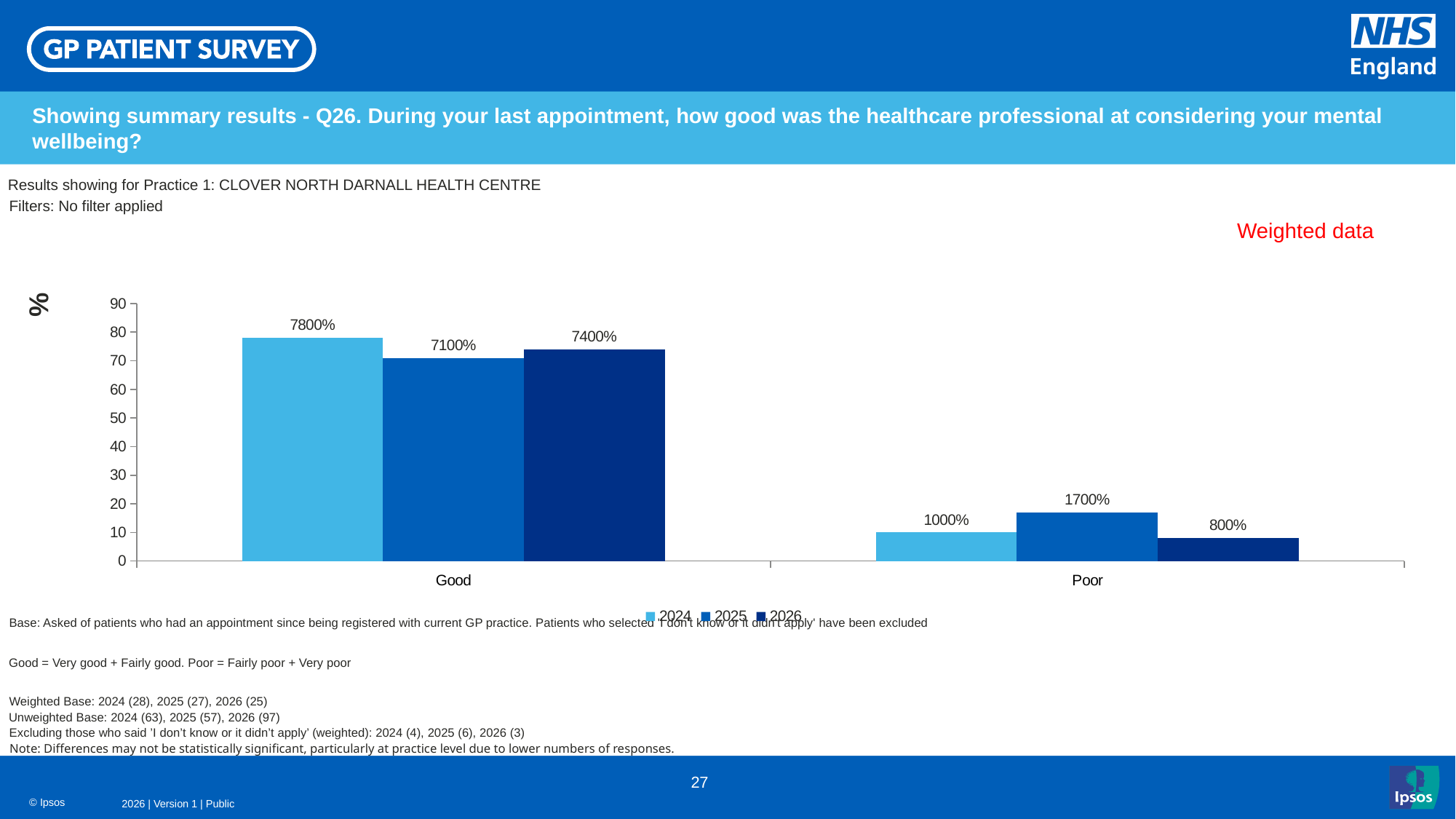
What is the value for 2025 in the Poor category? 1700% What is the value for 2025 in the Good category? 7100% What kind of chart is shown on the slide? Bar chart What is the difference between the 2024 and 2025 values in the Good category? 700% How many categories are shown on the x axis? 2 Which year has the highest value in the Good category? 2024 Which is larger in the Poor category: the 2024 value or the 2025 value? 2025 Which year has the lowest value in the Poor category? 2026 What is the value for 2024 in the Good category? 7800% What is the value for 2026 in the Poor category? 800% Which series is shown in the darkest blue colour? 2026 How many series does the legend list? 3